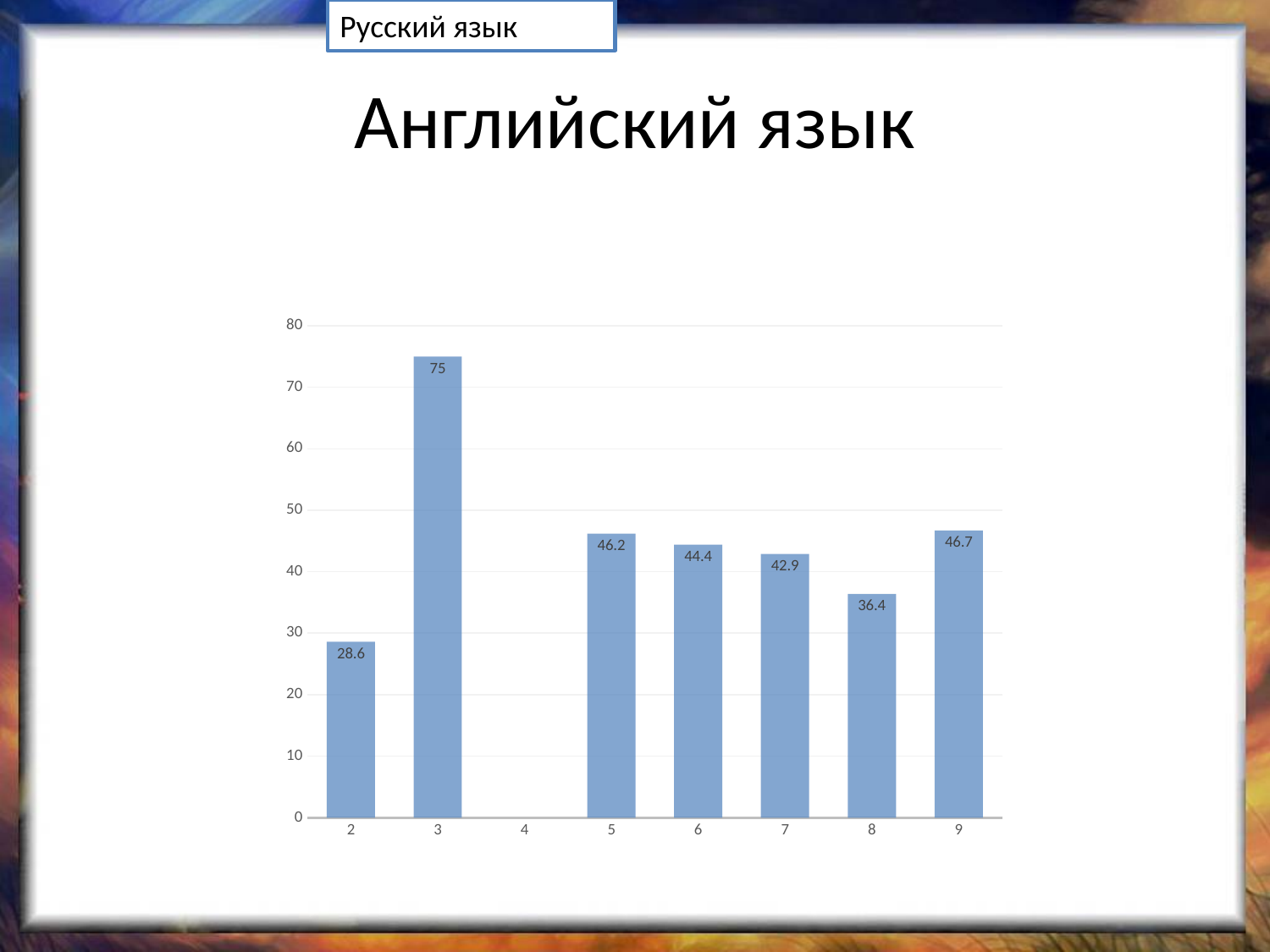
What is the difference between the values for category 3 and category 2? 46.4 Is the value for category 5 greater or less than 40? greater What is the title of the chart? Английский язык Which category has the highest value? 3 What is the value for category 2? 28.6 Which category with a plotted bar has the lowest value? 2 What is the value for category 8? 36.4 Which is larger, the value for category 6 or the value for category 7? category 6 What type of chart is shown on the slide? bar chart What is the value for category 3? 75 What is the value for category 9? 46.7 How many bars are plotted on the chart? 7